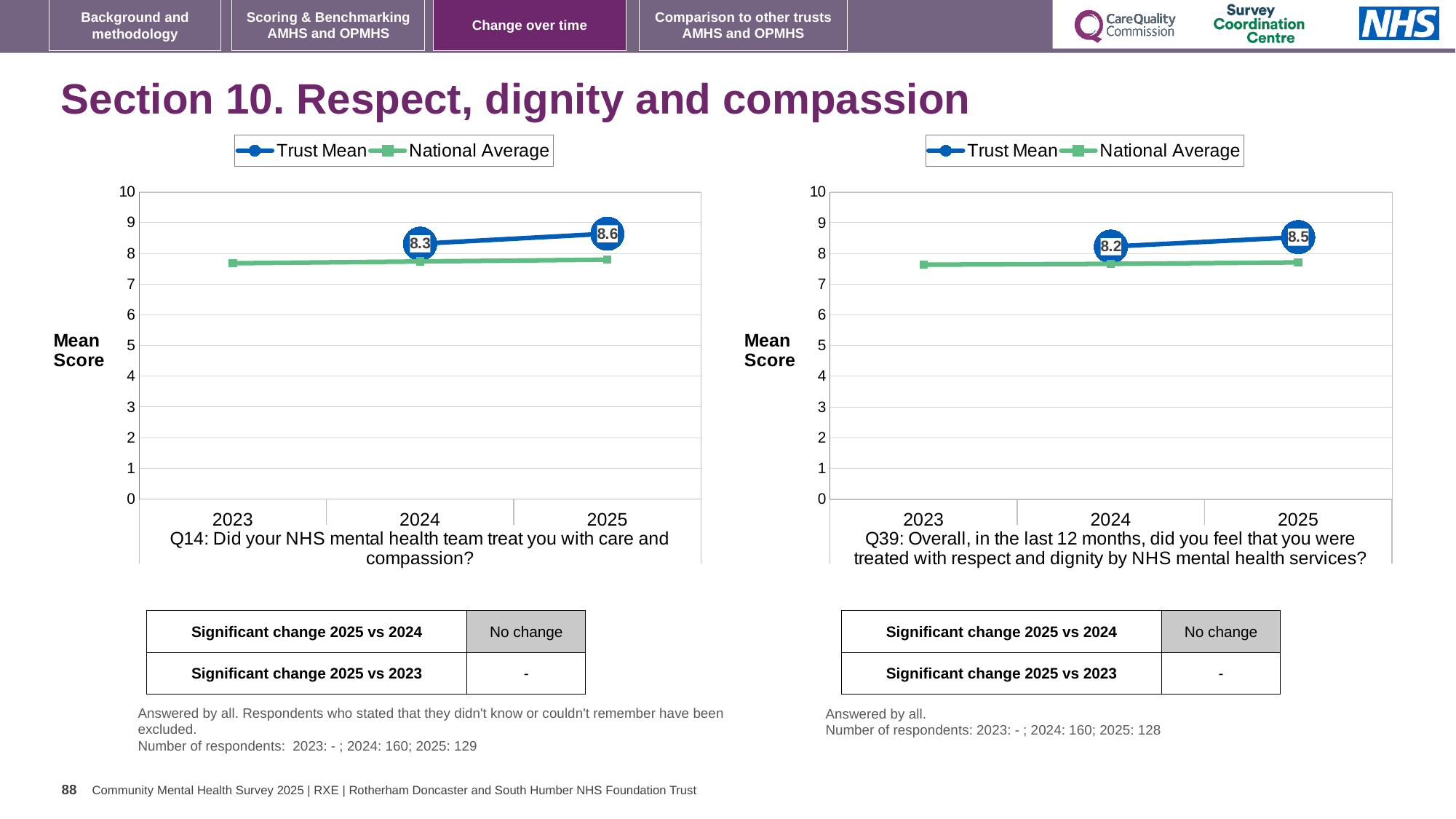
In the Q14 chart (left), by how much did the Trust Mean change from 2024 to 2025? 0.3 In the Q39 chart (right), what is the difference between the Trust Mean in 2025 and in 2024? 0.3 What type of chart is used for Q39 (right)? line chart How many series does the legend of the Q14 chart (left) list? 2 In the Q14 chart (left), what is the Trust Mean for 2024? 8.3 In the Q39 chart (right), what is the Trust Mean for 2024? 8.2 In the Q39 chart (right), which is higher in 2025: the Trust Mean or the National Average? Trust Mean In the Q14 chart (left), what is the Trust Mean for 2025? 8.6 In the Q14 chart (left), is the National Average for 2025 greater or less than 8? less In the Q14 chart (left), does the Trust Mean rise or fall from 2024 to 2025? rise In the Q39 chart (right), what is the Trust Mean for 2025? 8.5 How many years are shown on the x axis of the Q39 chart (right)? 3